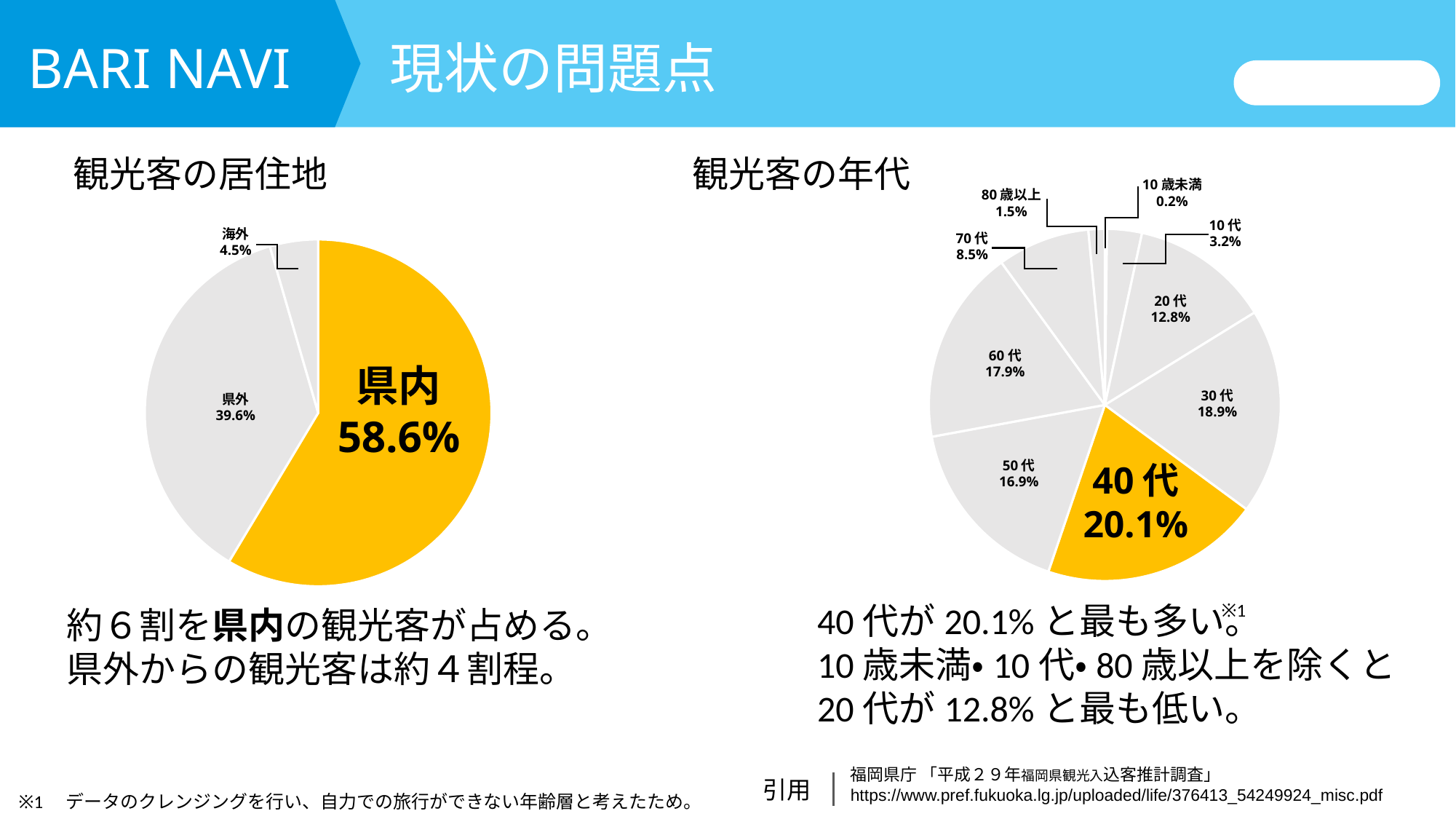
In the 観光客の年代 chart, what is the value for 30 代? 18.9% How many categories does the 観光客の居住地 chart show? 3 What kind of chart is the 観光客の年代 chart? Pie chart In the 観光客の年代 chart, which is larger, 50 代 or 60 代? 60 代 In the 観光客の居住地 chart, what is the difference between 県内 and 県外? 19.0% In the 観光客の居住地 chart, what is the value for 海外? 4.5% In the 観光客の居住地 chart, which category has the smallest share? 海外 In the 観光客の年代 chart, what is the value for 80 歳以上? 1.5% In the 観光客の年代 chart, which age group has the smallest share? 10 歳未満 In the 観光客の年代 chart, which age group has the largest share? 40 代 In the 観光客の居住地 chart, what is the value for 県内? 58.6% How many age groups does the 観光客の年代 chart show? 9